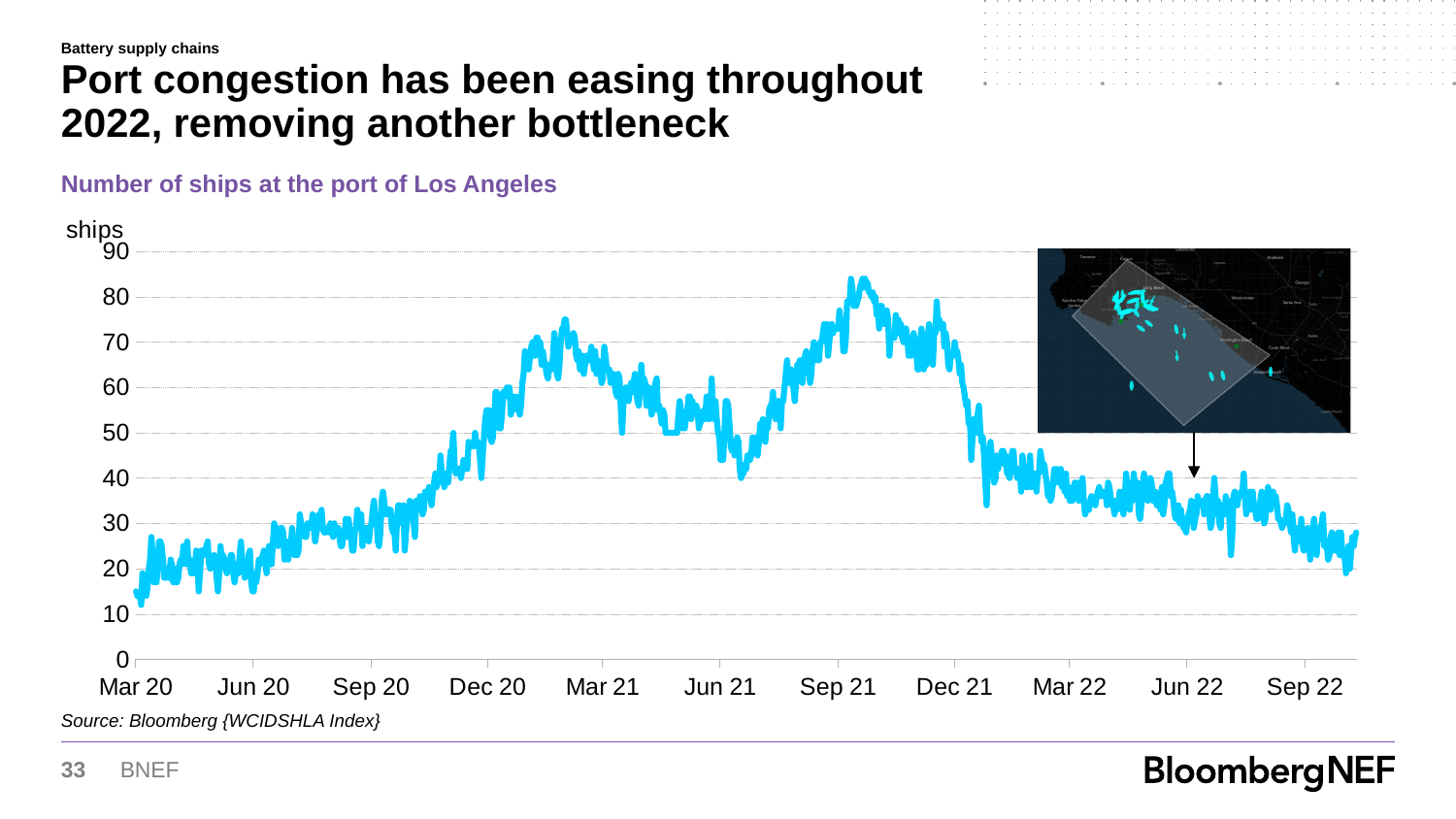
How many date labels are shown on the x axis? 11 Is the value at the start of the series in Mar 20 greater or less than 30? less Is the value at the end of the series around Sep 22 greater or less than 40? less What kind of chart is shown on the slide? Line chart Is the value around Mar 22 greater or less than 60? less Does the number of ships rise or fall between Mar 20 and Sep 21 overall? rise Which is higher, the number of ships around Sep 21 or around Sep 22? Sep 21 What is the title of the chart? Number of ships at the port of Los Angeles Around which x-axis label does the number of ships reach its highest point? Sep 21 Does the number of ships rise or fall between Dec 21 and Sep 22? fall What unit is shown on the vertical axis of the chart? ships